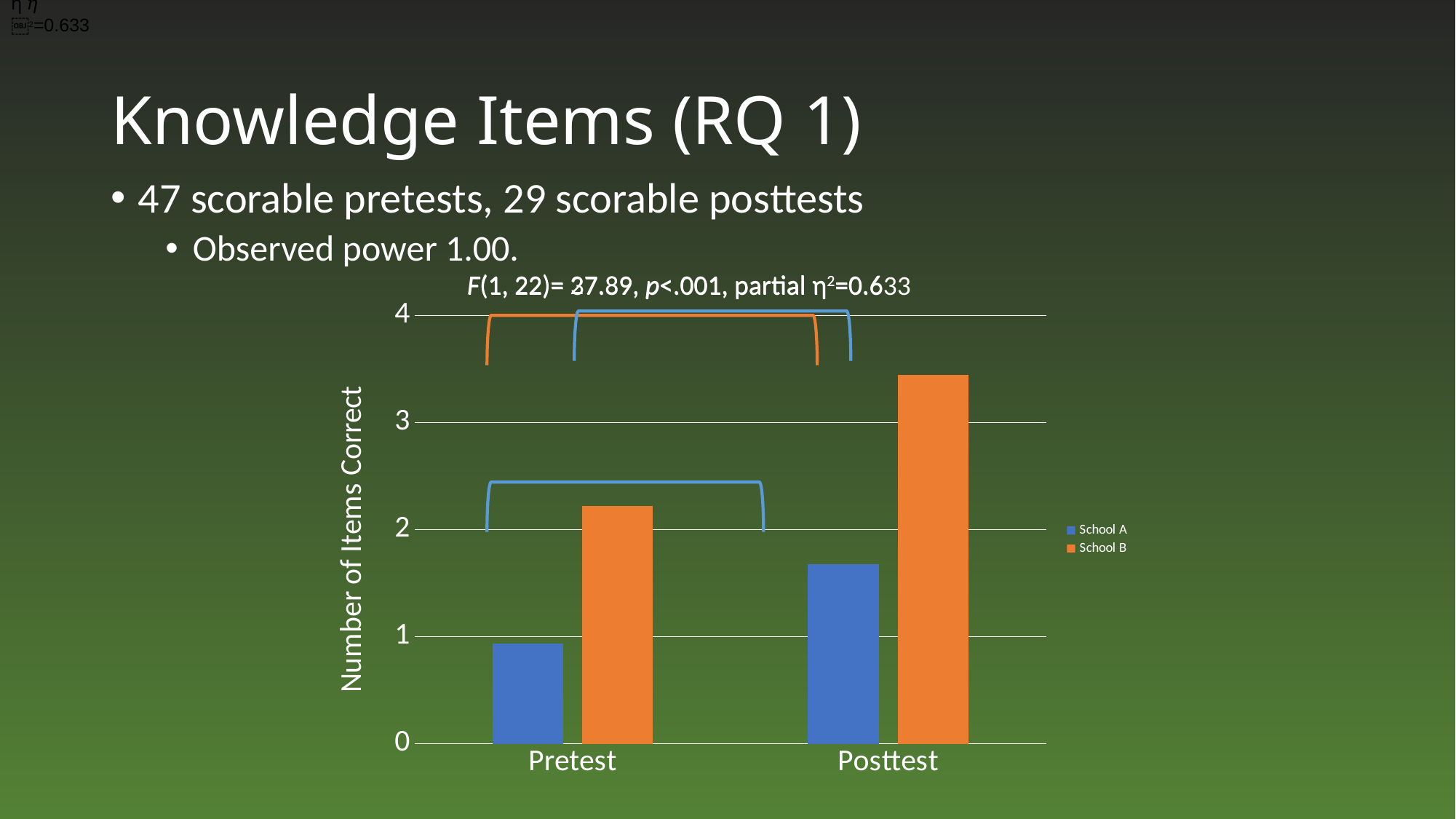
Which series and category has the shortest bar? School A, Pretest How many categories are shown on the x axis? 2 What kind of chart is shown on the slide? bar chart Is the value for School B at Posttest greater or less than 3? greater Which is larger at Posttest, School A or School B? School B What is the title of the y axis? Number of Items Correct Is the value for School B at Pretest greater or less than 2? greater Do the values for School B rise or fall from Pretest to Posttest? rise Which series and category has the tallest bar? School B, Posttest Which is larger for School A, Pretest or Posttest? Posttest How many series does the legend list? 2